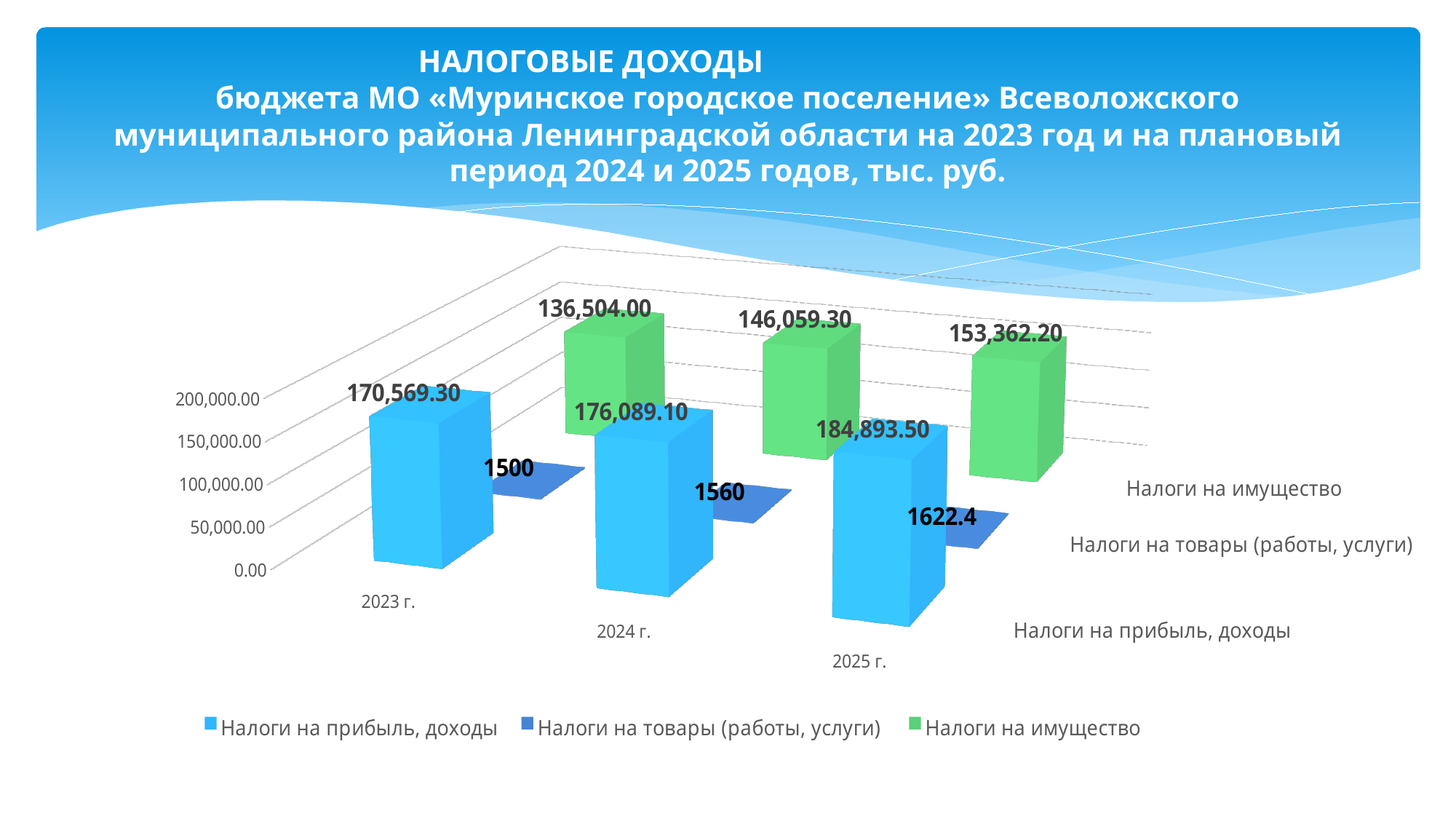
How many series does the legend list? 3 What is the difference between Налоги на прибыль, доходы in 2025 г. and in 2024 г.? 8,804.40 What is the value for Налоги на прибыль, доходы in 2023 г.? 170,569.30 Which is larger in 2024 г.: Налоги на прибыль, доходы or Налоги на имущество? Налоги на прибыль, доходы Do the values for Налоги на имущество rise or fall from 2023 г. to 2025 г.? Rise How many years are shown on the x axis of the chart? 3 In which year is Налоги на прибыль, доходы highest? 2025 г. In which year is Налоги на имущество lowest? 2023 г. What is the value for Налоги на товары (работы, услуги) in 2024 г.? 1560 What kind of chart is shown on the slide? Bar chart Which colour represents Налоги на имущество in the legend? Green What is the value for Налоги на имущество in 2025 г.? 153,362.20